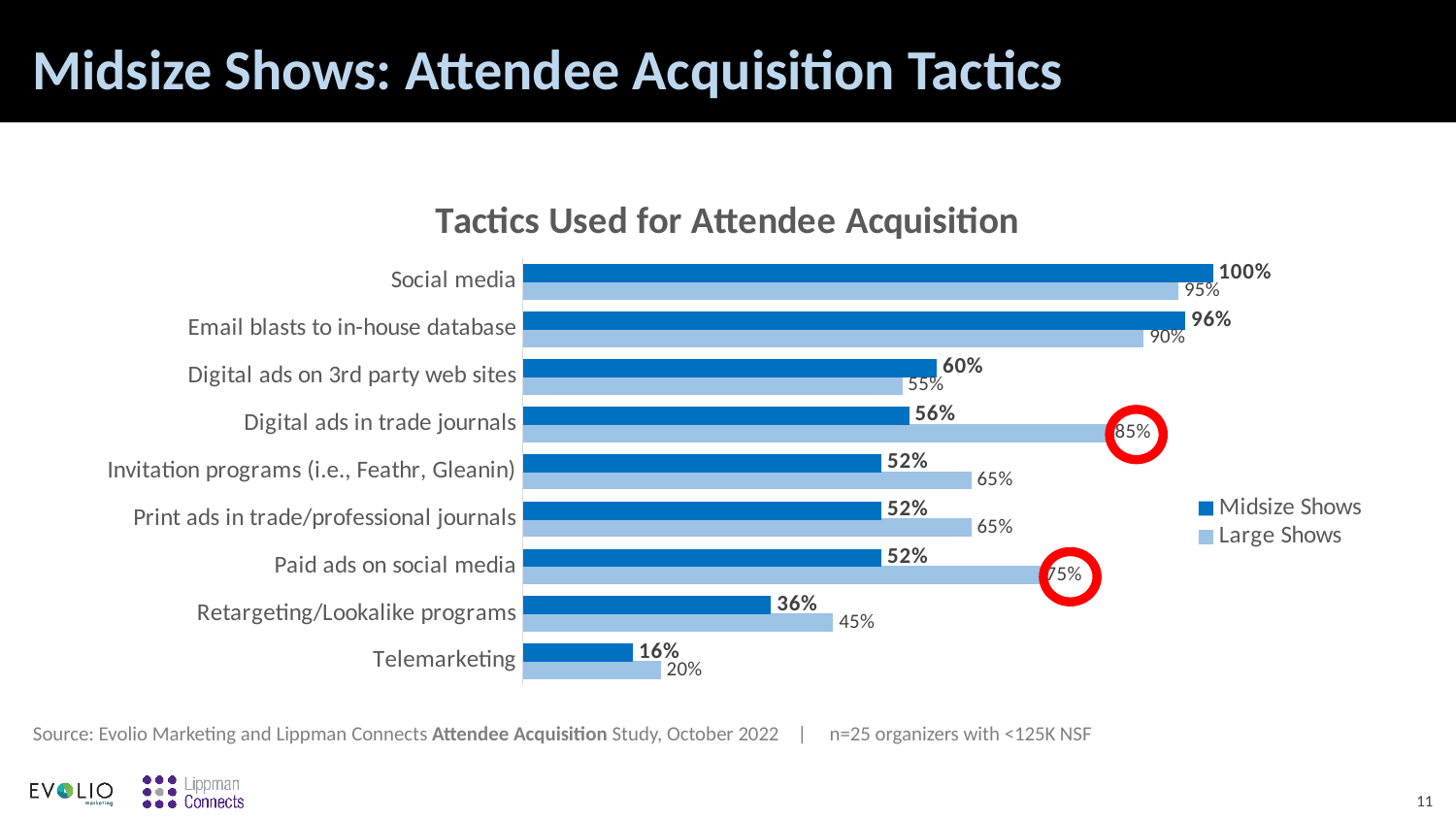
How many tactics are listed on the chart? 9 What percentage of Large Shows use Digital ads in trade journals? 85% What type of chart is shown on the slide? Bar chart How many series does the legend list? 2 What is the title of the chart? Tactics Used for Attendee Acquisition What is the Midsize Shows value for Telemarketing? 16% Which tactic has the lowest value for Midsize Shows? Telemarketing Which is larger for Digital ads in trade journals: the Midsize Shows value or the Large Shows value? Large Shows What is the difference between the Midsize Shows values for Email blasts to in-house database and Digital ads on 3rd party web sites? 36% What percentage of Midsize Shows use Social media for attendee acquisition? 100% What is the difference between the Large Shows and Midsize Shows values for Paid ads on social media? 23% Which tactic has the highest value for Large Shows? Social media